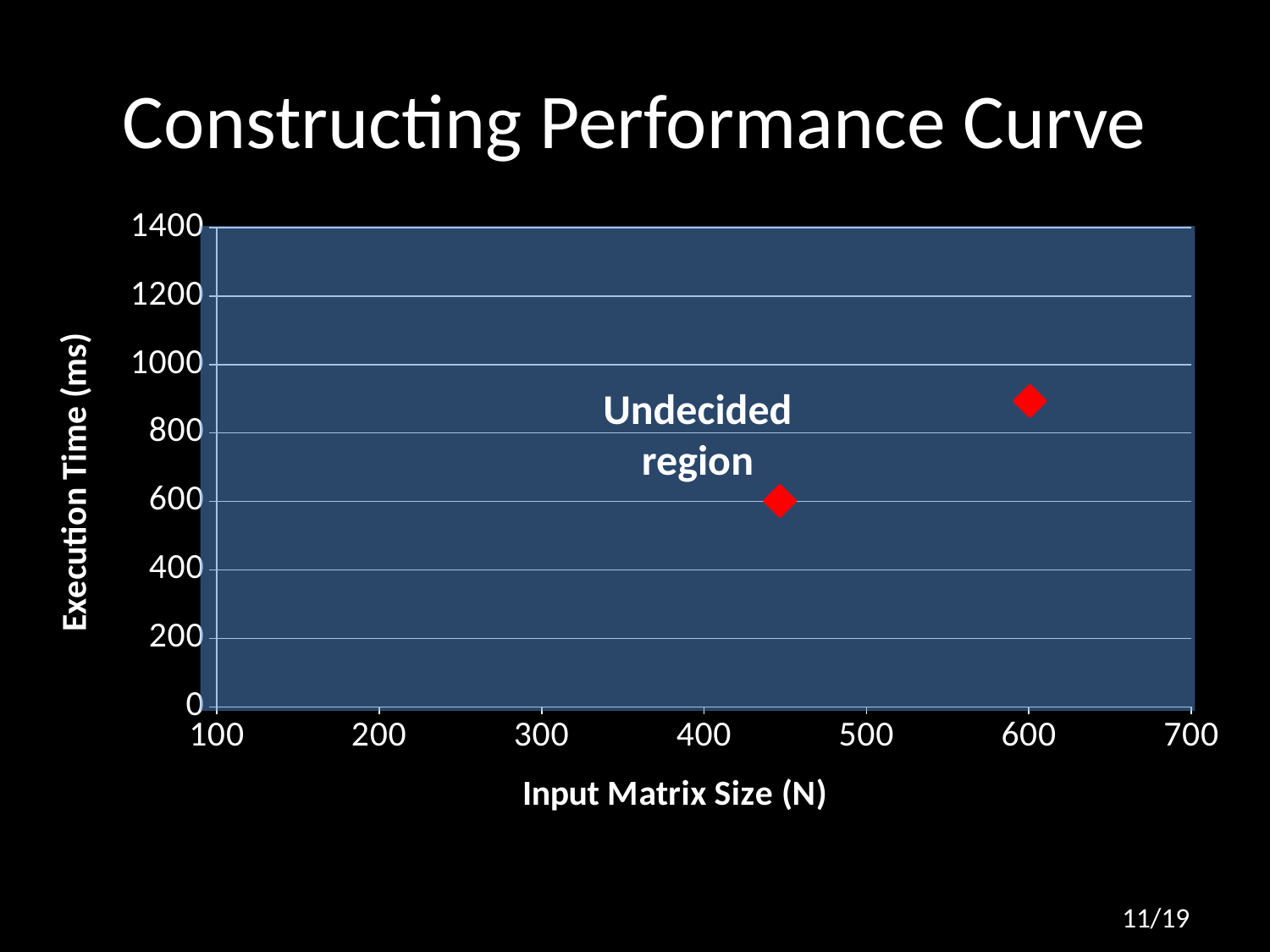
What is the title of the chart's y axis? Execution Time (ms) Is the execution time for the data point near an input matrix size of 600 greater or less than 800? greater Which data point has the lowest execution time? the one near an input matrix size of 450 Is the execution time for the data point near an input matrix size of 450 greater or less than 800? less What kind of chart is shown on the slide? scatter chart Does execution time rise or fall as input matrix size increases along the x axis? rise Is the execution time for the data point near an input matrix size of 600 greater or less than 1000? less How many data points are plotted on the chart? 2 What is the title of the chart's x axis? Input Matrix Size (N) What is the highest value shown on the y axis? 1400 Which data point has the higher execution time: the one near an input matrix size of 450 or the one near 600? the one near 600